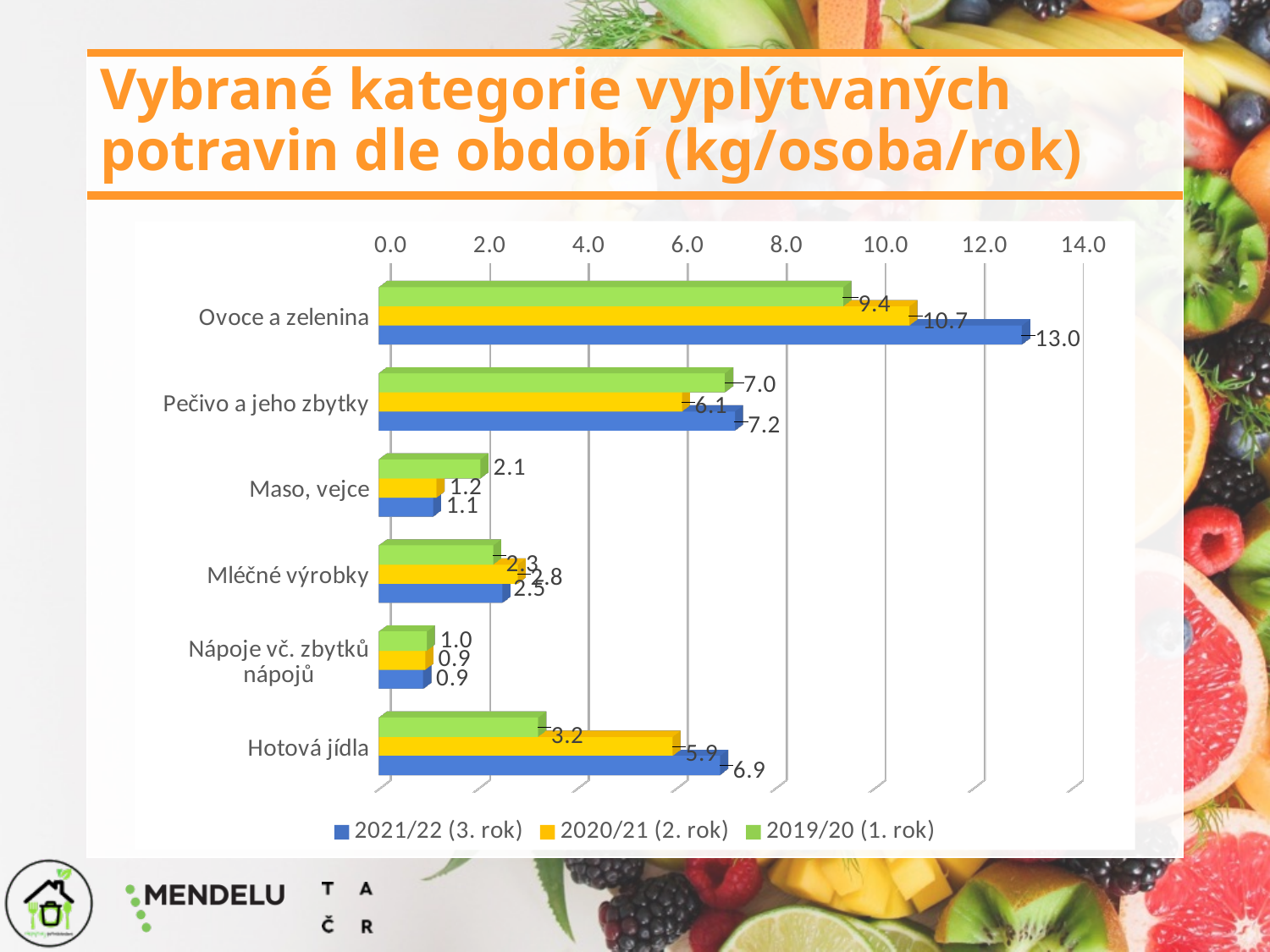
Which series is shown in green in the legend? 2019/20 (1. rok) What type of chart is shown on the slide? bar chart What is the value for Pečivo a jeho zbytky in 2020/21 (2. rok)? 6.1 Which category has the highest value in the 2021/22 (3. rok) series? Ovoce a zelenina Which is larger for Hotová jídla: the 2021/22 (3. rok) value or the 2019/20 (1. rok) value? 2021/22 (3. rok) What is the difference between the 2021/22 (3. rok) and 2019/20 (1. rok) values for Ovoce a zelenina? 3.6 Which category has the lowest value in the 2019/20 (1. rok) series? Nápoje vč. zbytků nápojů What is the value for Ovoce a zelenina in 2021/22 (3. rok)? 13.0 How many food categories are shown on the chart? 6 Is the value for Ovoce a zelenina in 2020/21 (2. rok) greater or less than 10.0? greater What is the value for Hotová jídla in 2019/20 (1. rok)? 3.2 How many series does the legend list? 3